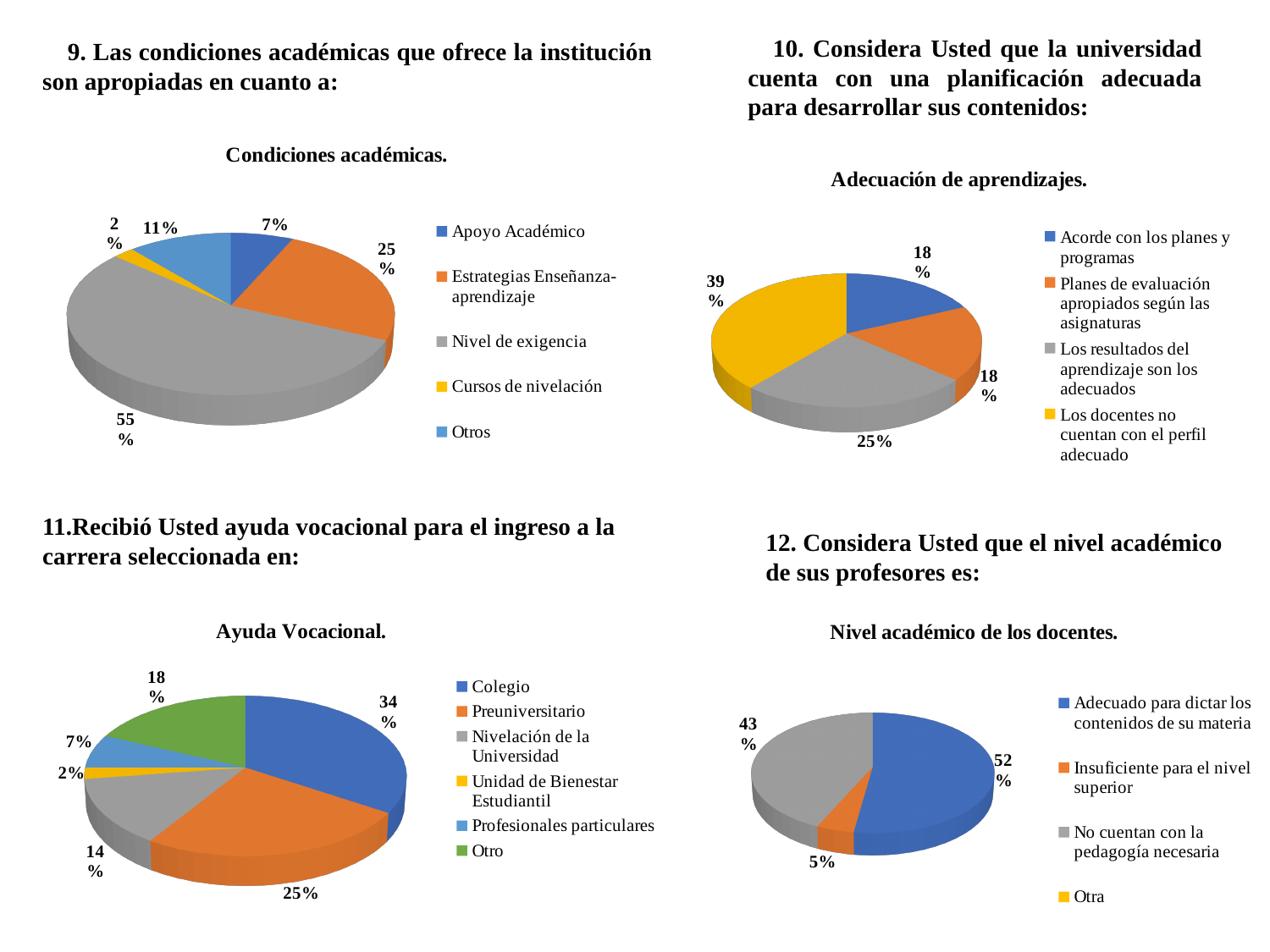
In the 'Adecuación de aprendizajes.' chart, which category has the largest share? Los docentes no cuentan con el perfil adecuado How many entries does the legend of the 'Adecuación de aprendizajes.' chart list? 4 In the 'Condiciones académicas.' chart, what is the difference between the shares for Estrategias Enseñanza-aprendizaje and Apoyo Académico? 18% In the 'Adecuación de aprendizajes.' chart, what percentage is shown for 'Los docentes no cuentan con el perfil adecuado'? 39% How many categories does the legend of the 'Ayuda Vocacional.' chart list? 6 In the 'Nivel académico de los docentes.' chart, what is the difference between the shares for 'Adecuado para dictar los contenidos de su materia' and 'No cuentan con la pedagogía necesaria'? 9% What type of chart is the 'Nivel académico de los docentes.' chart? Pie chart In the 'Nivel académico de los docentes.' chart, what percentage is shown for 'Insuficiente para el nivel superior'? 5% In the 'Ayuda Vocacional.' chart, what percentage is shown for Colegio? 34% In the 'Condiciones académicas.' chart, what percentage is shown for Nivel de exigencia? 55% In the 'Condiciones académicas.' chart, which category has the smallest share? Cursos de nivelación In the 'Ayuda Vocacional.' chart, which is larger, Preuniversitario or Nivelación de la Universidad? Preuniversitario